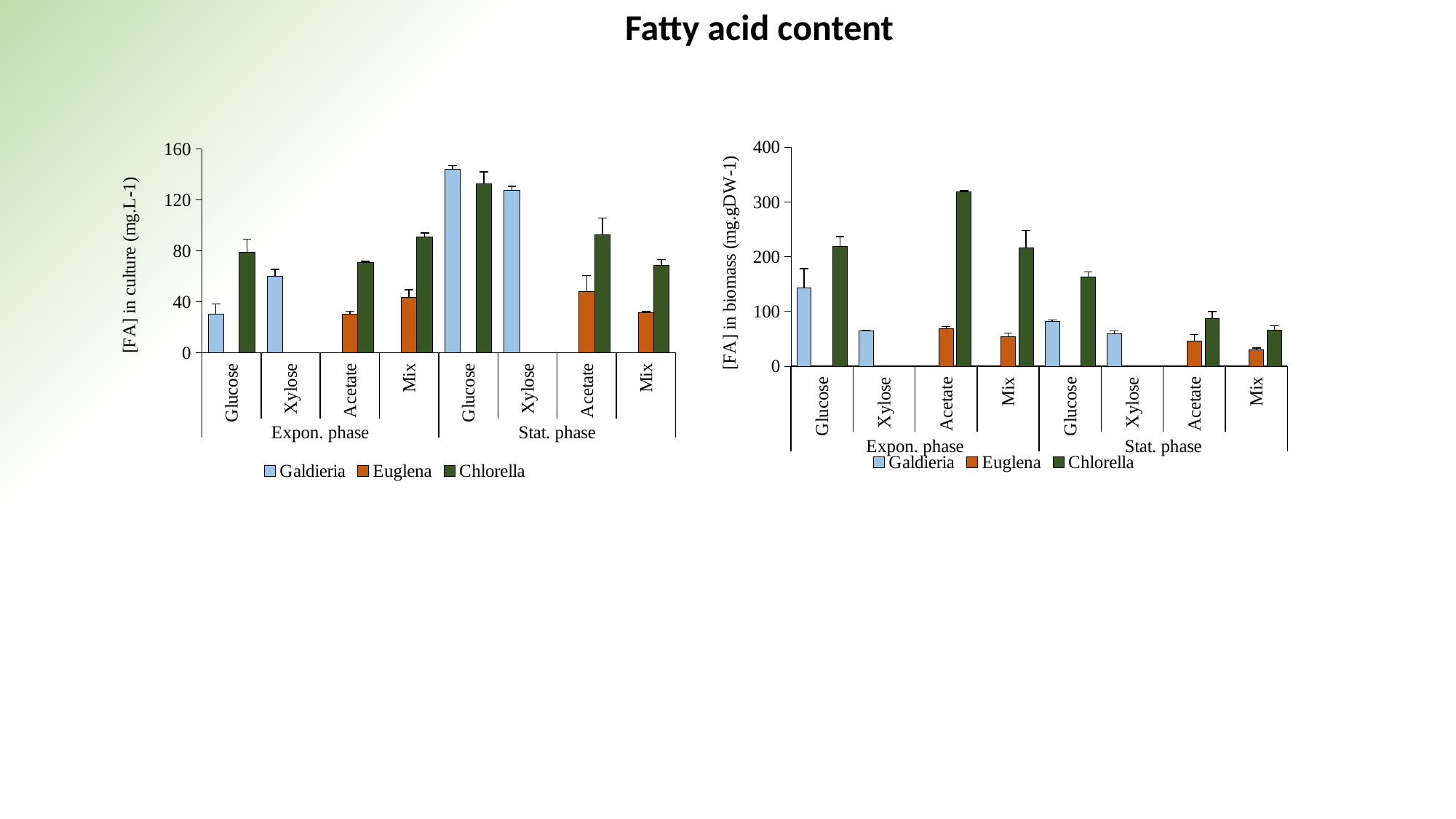
How many series does the legend of the right chart, [FA] in biomass (mg.gDW-1), list? 3 In the right chart, [FA] in biomass (mg.gDW-1), is the value for Chlorella at Glucose in the Stat. phase greater or less than 200? less How many substrate categories are shown along the x axis of the left chart, [FA] in culture (mg.L-1)? 8 What kind of chart is the left chart, [FA] in culture (mg.L-1)? bar chart In the right chart, [FA] in biomass (mg.gDW-1), is the value for Chlorella at Acetate in the Expon. phase greater or less than 300? greater In the right chart, [FA] in biomass (mg.gDW-1), which is larger at Mix in the Stat. phase: Euglena or Chlorella? Chlorella In the left chart, [FA] in culture (mg.L-1), is the value for Chlorella at Acetate in the Expon. phase greater or less than 80? less In the left chart, [FA] in culture (mg.L-1), which bar is the highest? Galdieria, Glucose, Stat. phase In the right chart, [FA] in biomass (mg.gDW-1), which bar is the highest? Chlorella, Acetate, Expon. phase What is the title of the slide containing the two charts? Fatty acid content In the left chart, [FA] in culture (mg.L-1), which is larger at Glucose in the Expon. phase: Galdieria or Chlorella? Chlorella